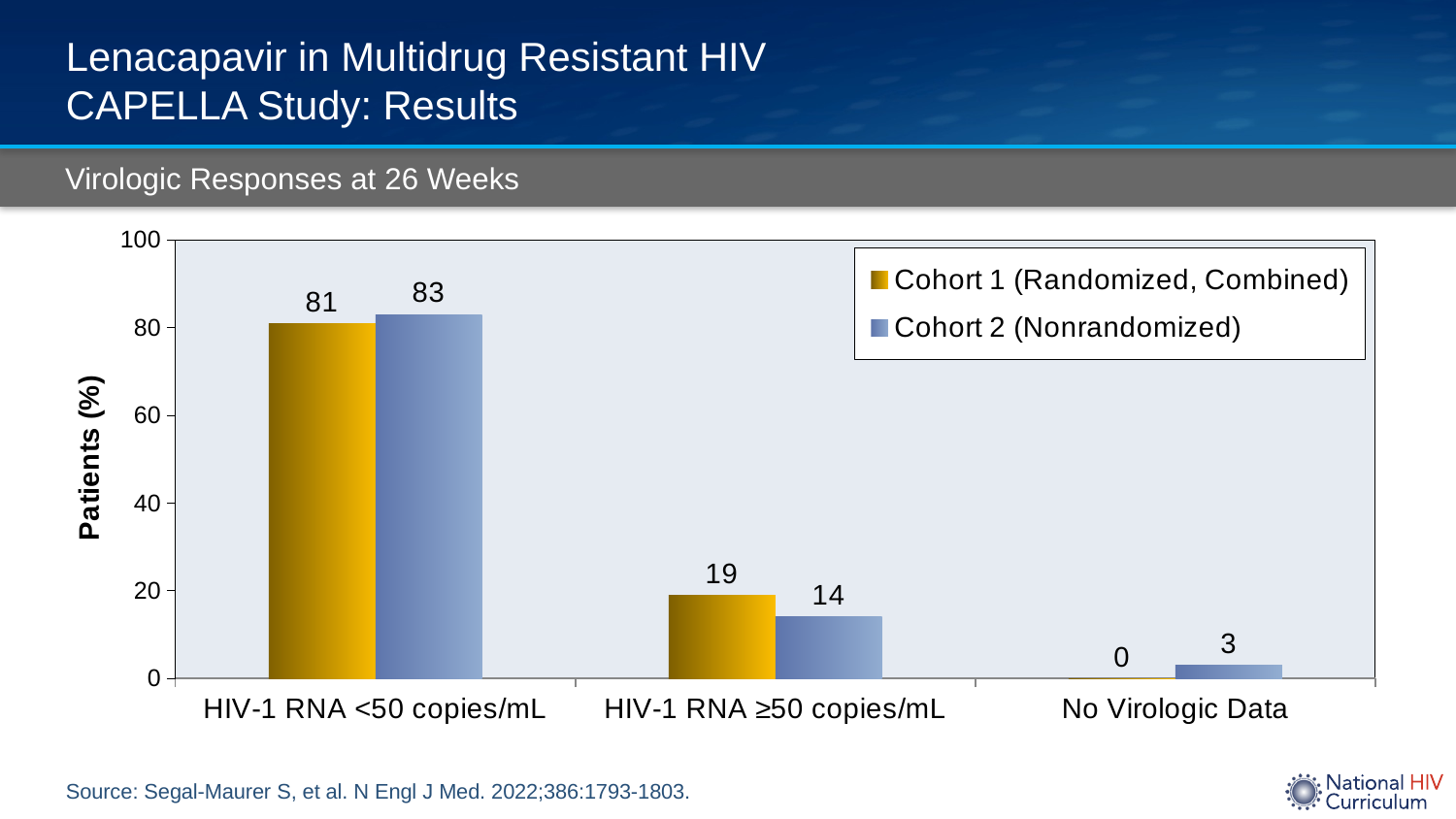
Which category has the highest value for Cohort 2 (Nonrandomized)? HIV-1 RNA <50 copies/mL What is the label of the y axis? Patients (%) What percentage of patients in Cohort 1 (Randomized, Combined) had HIV-1 RNA <50 copies/mL? 81 Which category has the lowest value for Cohort 1 (Randomized, Combined)? No Virologic Data What is the difference between Cohort 1 and Cohort 2 in the HIV-1 RNA ≥50 copies/mL category? 5 What is the value for Cohort 2 (Nonrandomized) in the No Virologic Data category? 3 In the HIV-1 RNA <50 copies/mL category, which cohort has the larger value? Cohort 2 (Nonrandomized) What percentage of patients in Cohort 2 (Nonrandomized) had HIV-1 RNA ≥50 copies/mL? 14 How many categories are shown on the x axis? 3 Is the value for Cohort 1 (Randomized, Combined) in the HIV-1 RNA <50 copies/mL category greater or less than 60? greater What kind of chart is shown on the slide? Bar chart How many series does the legend list? 2